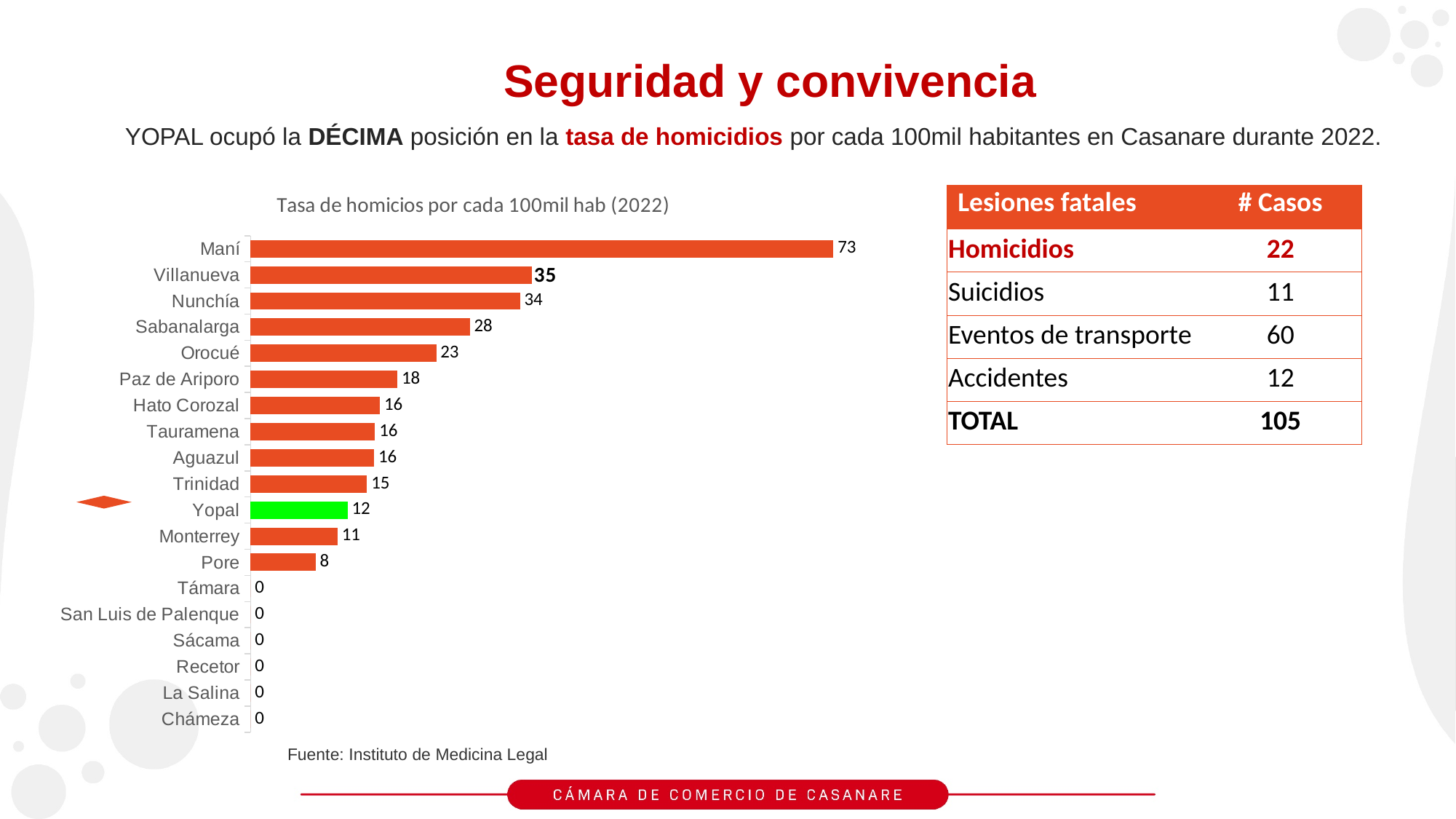
What type of chart is shown on the slide? Bar chart Which bar in the chart is coloured green instead of orange? Yopal Which has a larger value, Monterrey or Trinidad? Trinidad What is the difference between the values for Yopal and Pore? 4 What is the value for Yopal in the chart? 12 What is the value for Sabanalarga in the chart? 28 What is the difference between the values for Maní and Villanueva? 38 How many municipalities are listed in the chart? 19 What is the title of the chart? Tasa de homicios por cada 100mil hab (2022) Which municipality has the highest value in the chart? Maní What is the value for Maní in the chart? 73 Which has a larger value, Orocué or Paz de Ariporo? Orocué